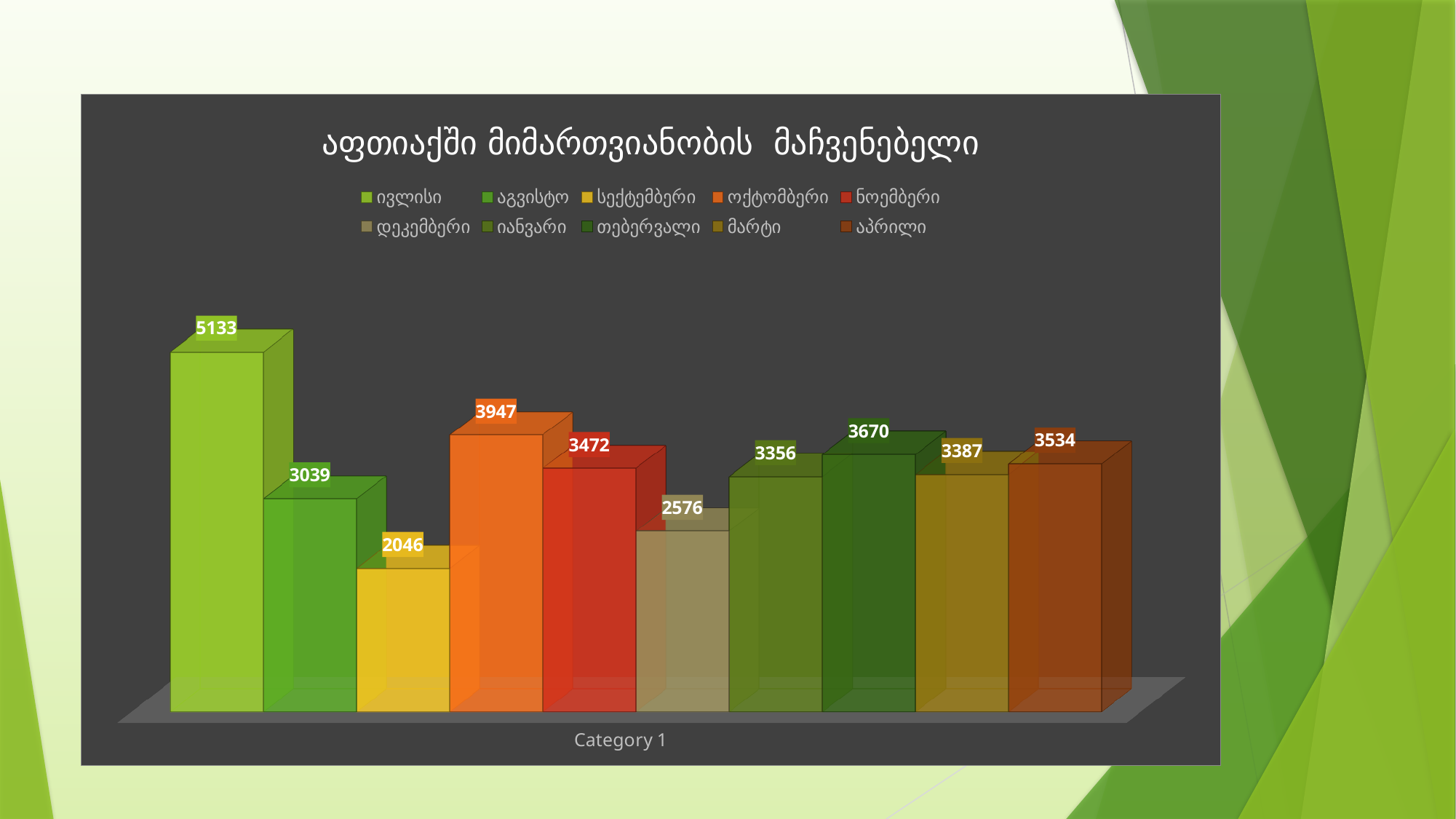
What is the value for ივლისი (July)? 5133 What is the value for სექტემბერი (September)? 2046 What is the difference between the values for ივლისი (5133) and აგვისტო (3039)? 2094 What is the value for აპრილი (April)? 3534 What is the category label shown on the x axis? Category 1 What is the difference between the values for ოქტომბერი (3947) and ნოემბერი (3472)? 475 What kind of chart is shown on the slide? Bar chart Which month has the highest value? ივლისი How many series does the legend list? 10 Which month has the lowest value? სექტემბერი What is the value for თებერვალი (February)? 3670 Which is larger, the value for დეკემბერი or the value for იანვარი? იანვარი